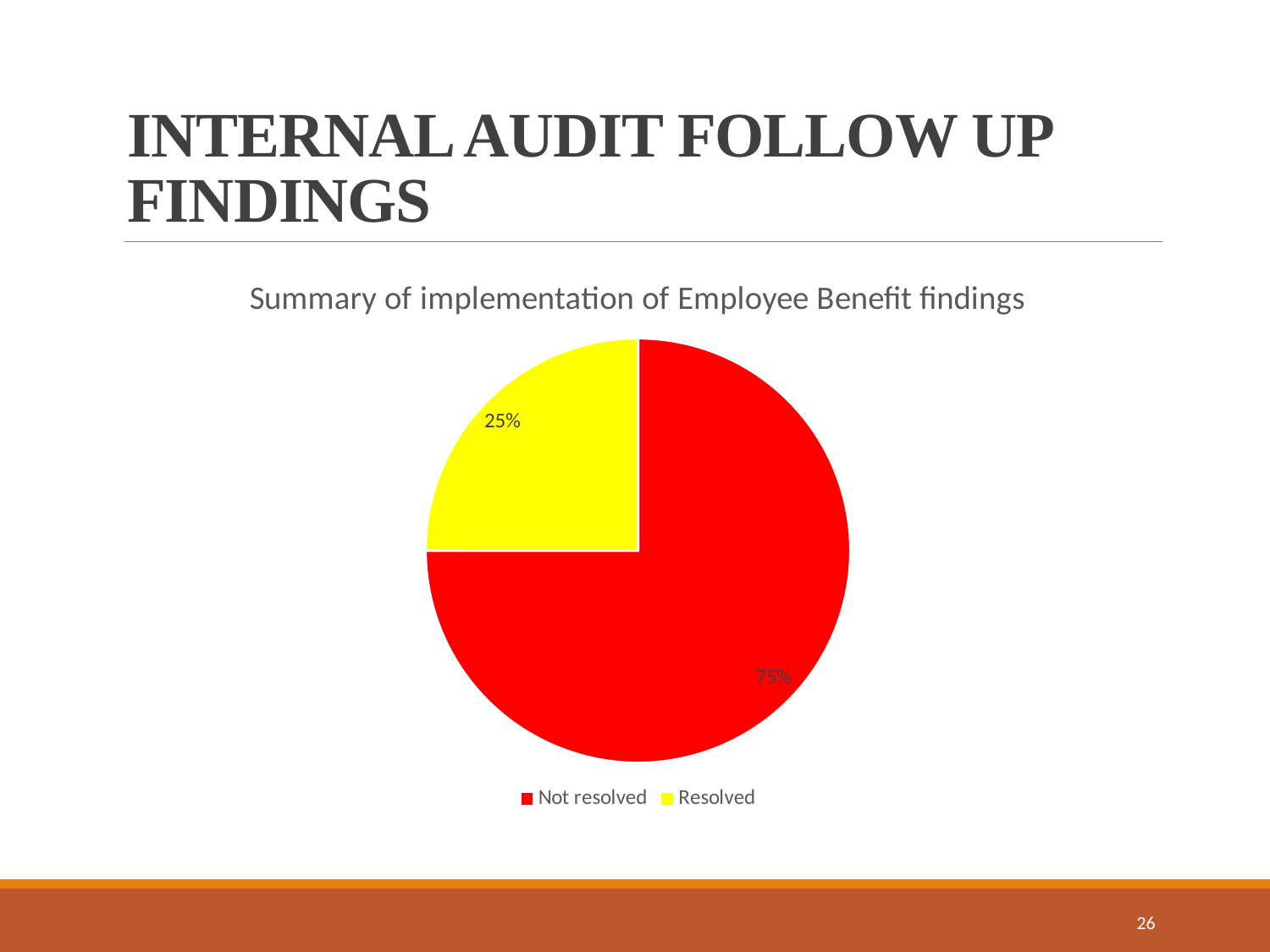
What is the title of the chart? Summary of implementation of Employee Benefit findings What share of the pie is labelled Not resolved? 75% How many categories does the pie chart show? 2 What colour is the Resolved slice? Yellow Which is larger, the Resolved slice or the Not resolved slice? Not resolved Which category has the smallest slice of the pie? Resolved Which category has the largest slice of the pie? Not resolved What share of the pie is labelled Resolved? 25% How many entries does the legend list? 2 What type of chart is shown on the slide? Pie chart What is the difference in percentage points between the Not resolved and Resolved slices? 50%